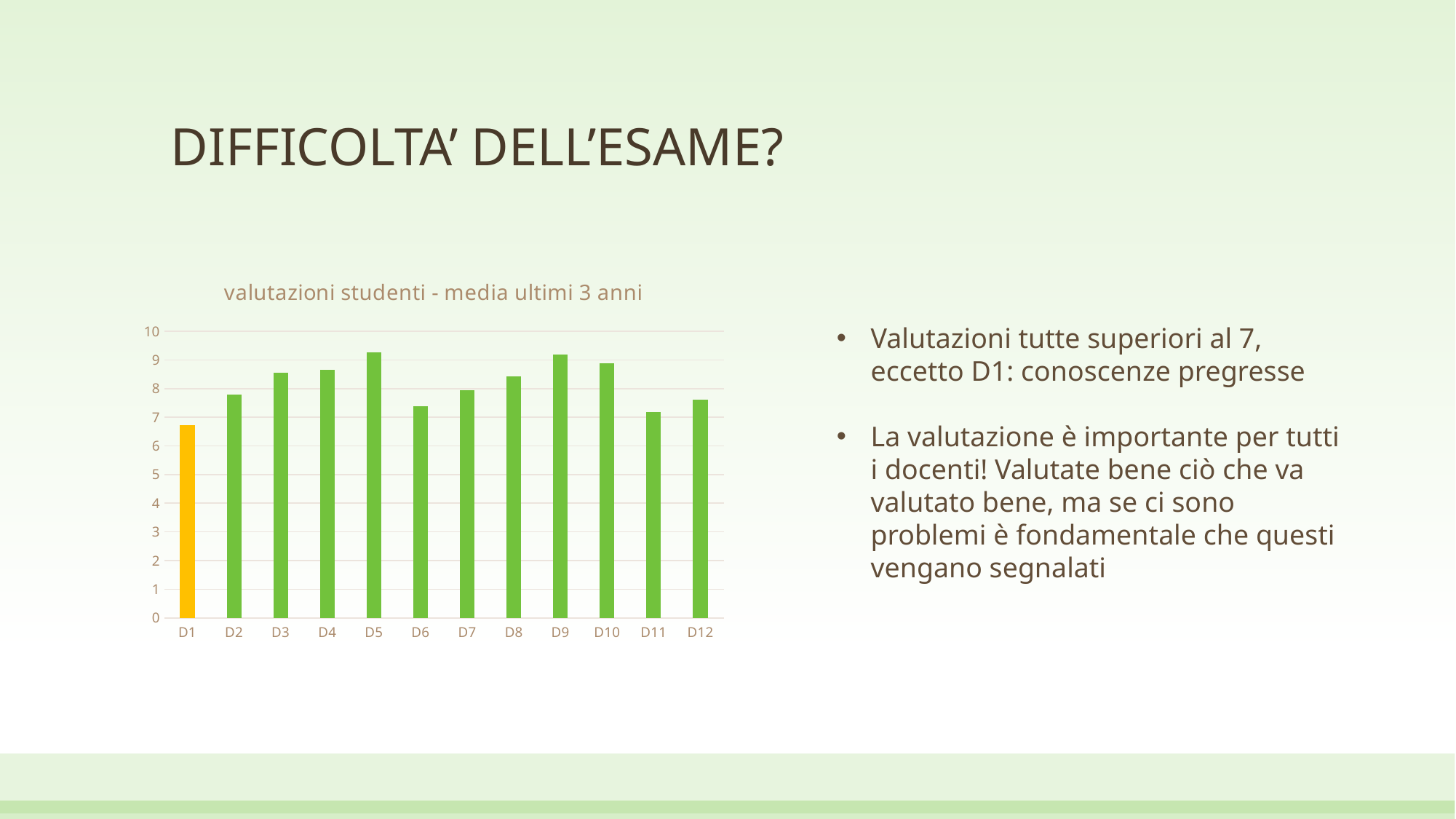
Is the value for D5 greater or less than 9? greater How many categories are plotted in the chart? 12 Is the value for D10 greater or less than 8? greater Is the value for D6 greater or less than 8? less Which bar in the chart is coloured differently from the others? D1 Which has the larger value, D1 or D2? D2 Which has the larger value, D5 or D6? D5 Which category has the lowest value in the chart? D1 What is the title of the chart? valutazioni studenti - media ultimi 3 anni What kind of chart is shown on the slide? bar chart